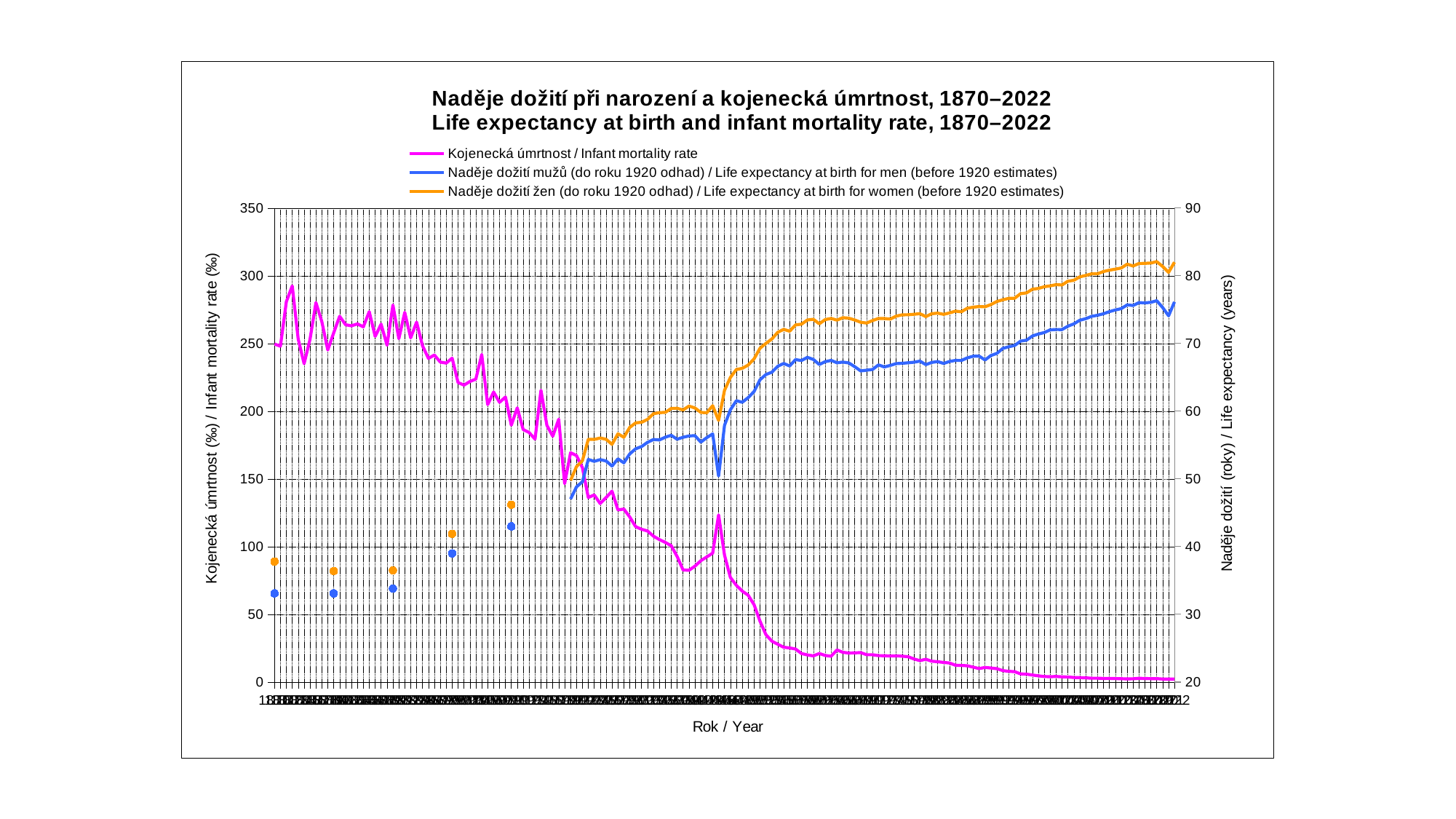
At the right end of the chart (2022), is life expectancy at birth for women greater or less than 80? greater How many series does the legend list? 3 Does life expectancy at birth for women rise or fall overall across the period shown? rise Does the infant mortality rate rise or fall overall from 1870 to 2022? fall At the left end of the chart (1870), is the infant mortality rate greater or less than 200? greater Does life expectancy at birth for men rise or fall overall across the period shown? rise At the right end of the chart (2022), is the infant mortality rate greater or less than 50? less What is the label of the x axis? Rok / Year What kind of chart is shown on the slide? line chart What is the English title of the chart? Life expectancy at birth and infant mortality rate, 1870–2022 At the right end of the chart (2022), which is higher: life expectancy at birth for men or for women? women